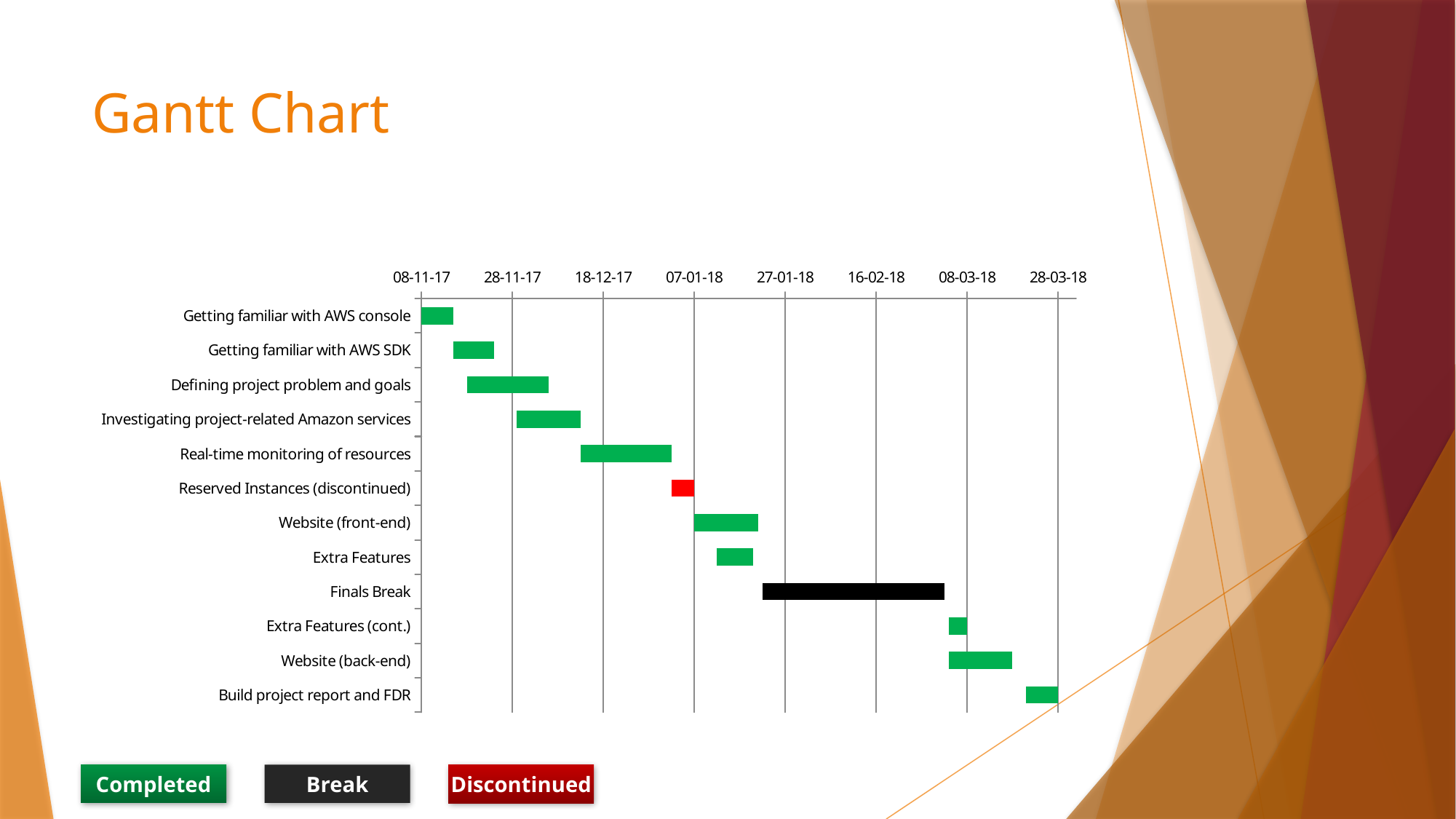
Which task has the longest bar on the Gantt chart? Finals Break How many tasks are listed on the Gantt chart? 12 How many status categories does the legend below the chart list? 3 Does the bar for 'Real-time monitoring of resources' end before or after 07-01-18? before On what date does the bar for 'Getting familiar with AWS console' start? 08-11-17 On what date does the bar for 'Website (front-end)' start? 07-01-18 Which task is shown with a red bar? Reserved Instances (discontinued) Which bar is longer: 'Finals Break' or 'Website (back-end)'? Finals Break What kind of chart is shown on the slide? Gantt chart (horizontal bar chart) Which task is the last to finish on the Gantt chart? Build project report and FDR On what date does the bar for 'Build project report and FDR' end? 28-03-18 Which task is shown with a black bar? Finals Break